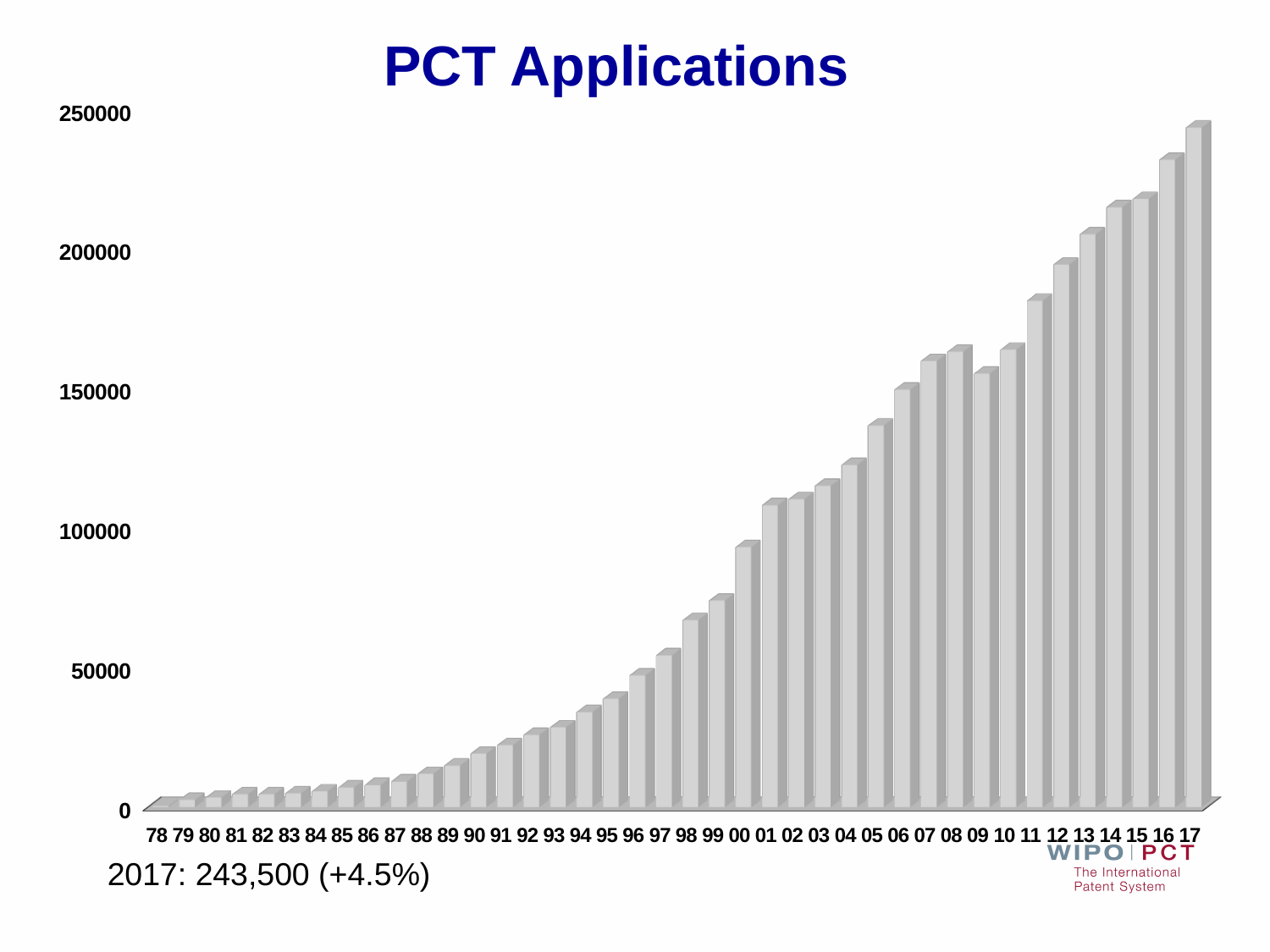
Do the values generally rise or fall from 78 to 17 along the x axis? rise Which year has the highest number of PCT applications? 17 Is the value for 14 greater or less than 200000? greater What percentage change for 2017 is stated on the slide? +4.5% Which year has the lowest number of PCT applications? 78 What kind of chart is shown on the slide? bar chart How many years (bars) are plotted on the chart? 40 Is the value for 05 greater or less than 100000? greater Which year has the larger value, 08 or 09? 08 Is the value for 95 greater or less than 50000? less What is the title of the chart? PCT Applications What is the number of PCT applications for 2017, as stated on the slide? 243,500